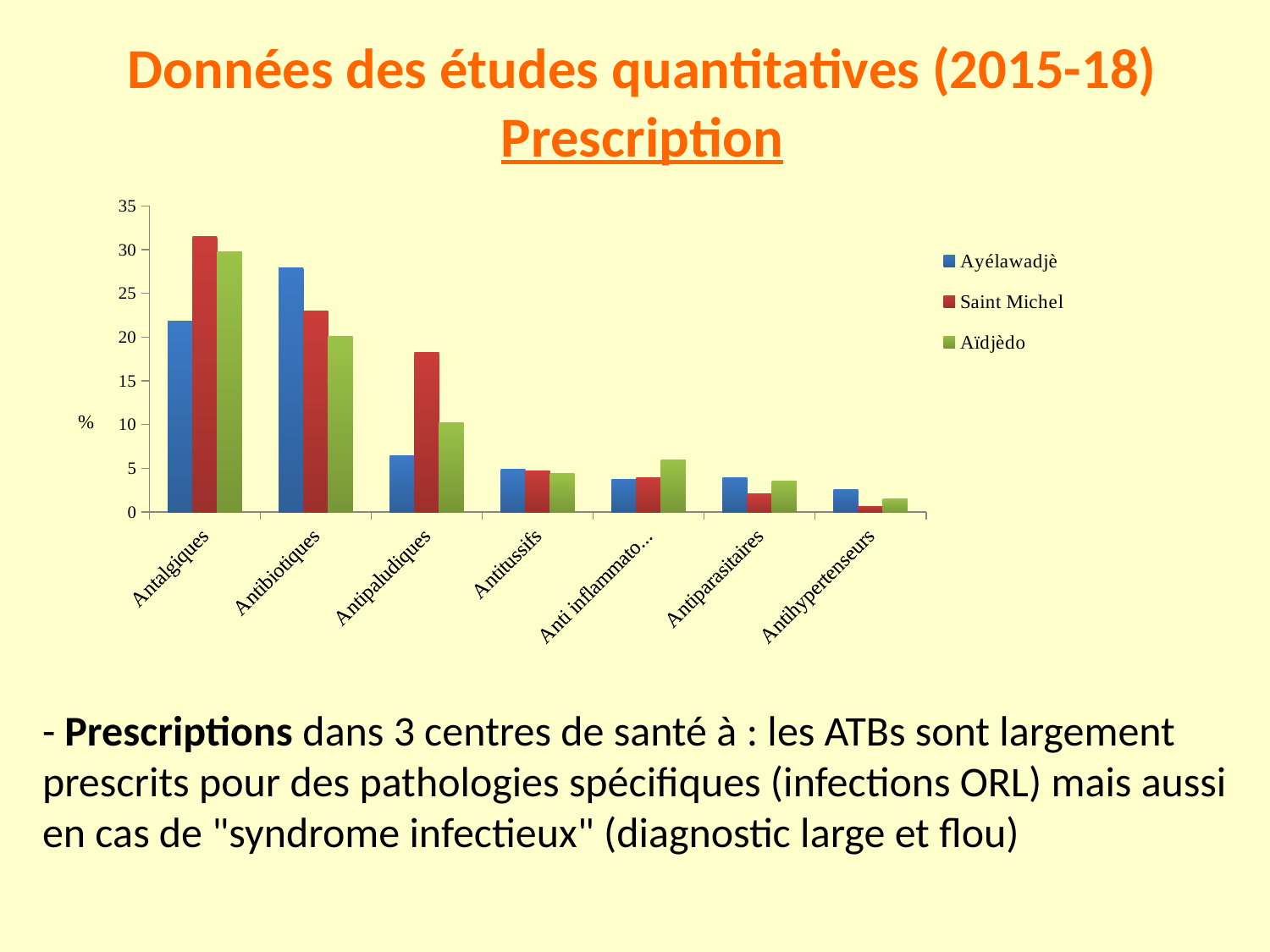
Which category has the highest value for Saint Michel? Antalgiques Which category has the highest value for Ayélawadjè? Antibiotiques Is the Ayélawadjè value for Antibiotiques greater or less than 25? greater What kind of chart is shown on the slide? bar chart Is the Ayélawadjè value for Antipaludiques greater or less than 10? less How many categories are shown on the x axis? 7 For Antipaludiques, which is larger: the Saint Michel value or the Aïdjèdo value? Saint Michel Which category has the lowest value for Saint Michel? Antihypertenseurs How many series does the legend list? 3 For Antalgiques, which is larger: the Ayélawadjè value or the Saint Michel value? Saint Michel What is the label on the vertical axis of the chart? % Is the Saint Michel value for Antalgiques greater or less than 30? greater